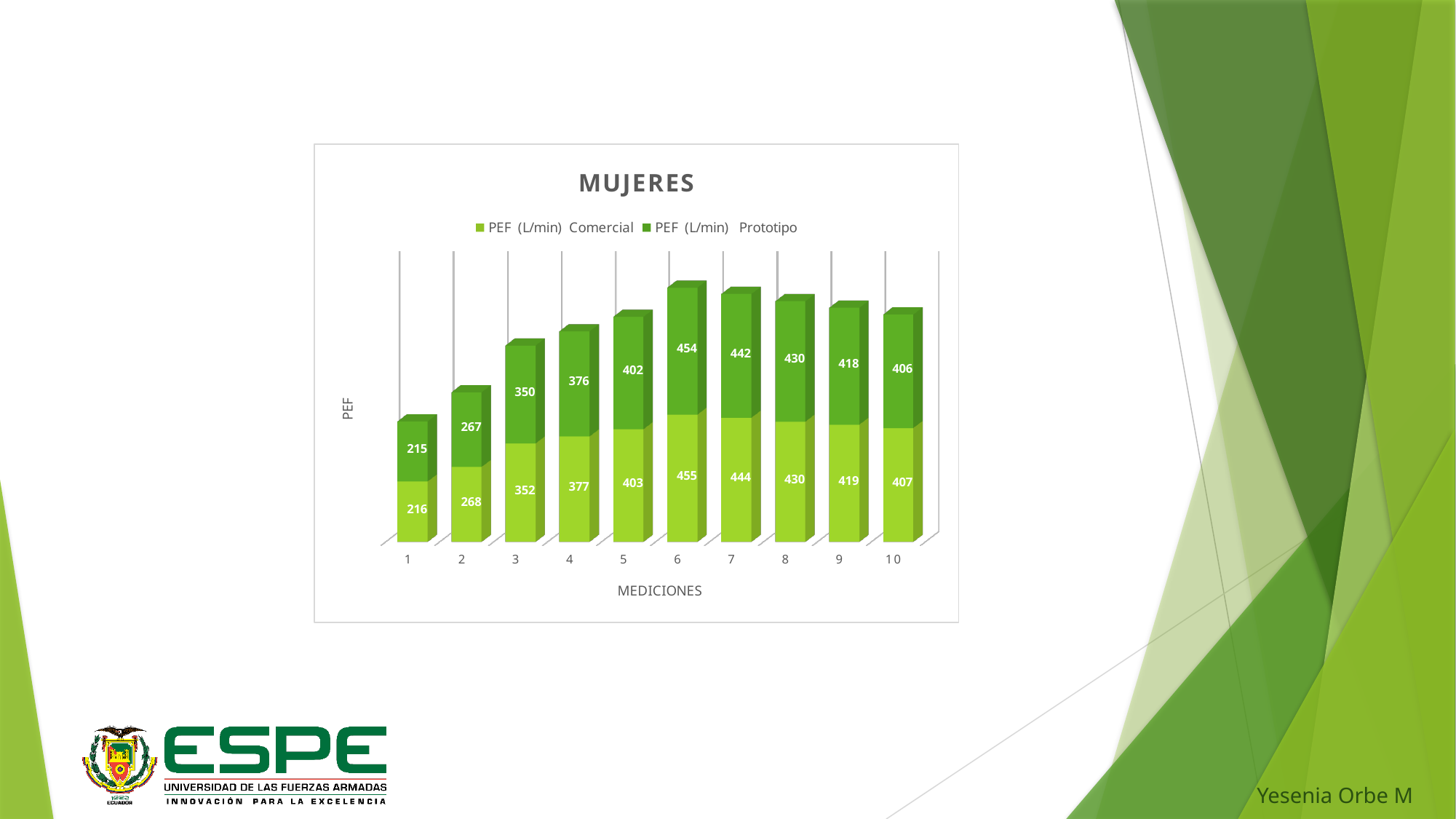
What is the PEF (L/min) Comercial value for medición 6? 455 What is the PEF (L/min) Prototipo value for medición 3? 350 What is the difference between the PEF (L/min) Comercial and PEF (L/min) Prototipo values for medición 7? 2 Which is larger: the PEF (L/min) Prototipo value for medición 4 or for medición 9? medición 9 What is the PEF (L/min) Comercial value for medición 1? 216 What is the title of the chart? MUJERES How many mediciones are shown on the x axis? 10 What is the total of the stacked bar for medición 10? 813 How many series does the legend list? 2 Which medición has the highest PEF (L/min) Prototipo value? 6 What kind of chart is shown on the slide? stacked bar chart Which medición has the lowest PEF (L/min) Comercial value? 1